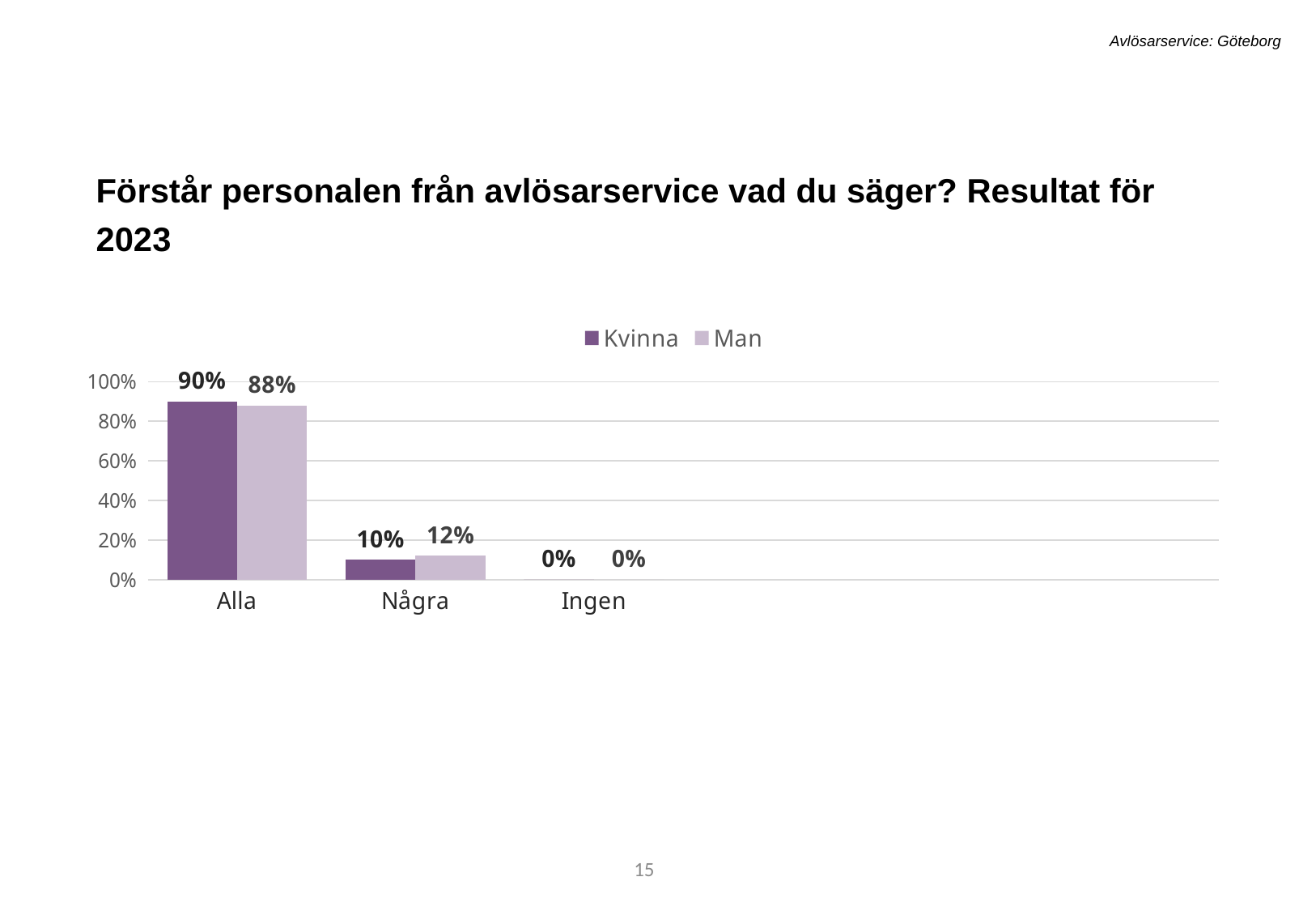
What is the difference between the Kvinna and Man values in the Alla category? 2% Which category has the highest value for the Kvinna series? Alla What is the value for Man in the Några category? 12% How many categories are shown on the x axis? 3 Which series is shown in the darker purple colour? Kvinna What is the value for Kvinna in the Alla category? 90% What kind of chart is shown on the slide? Bar chart What is the value for Man in the Alla category? 88% What is the value for Kvinna in the Ingen category? 0% How many series does the legend list? 2 What is the value for Kvinna in the Några category? 10% In the Några category, which series has the larger value, Kvinna or Man? Man